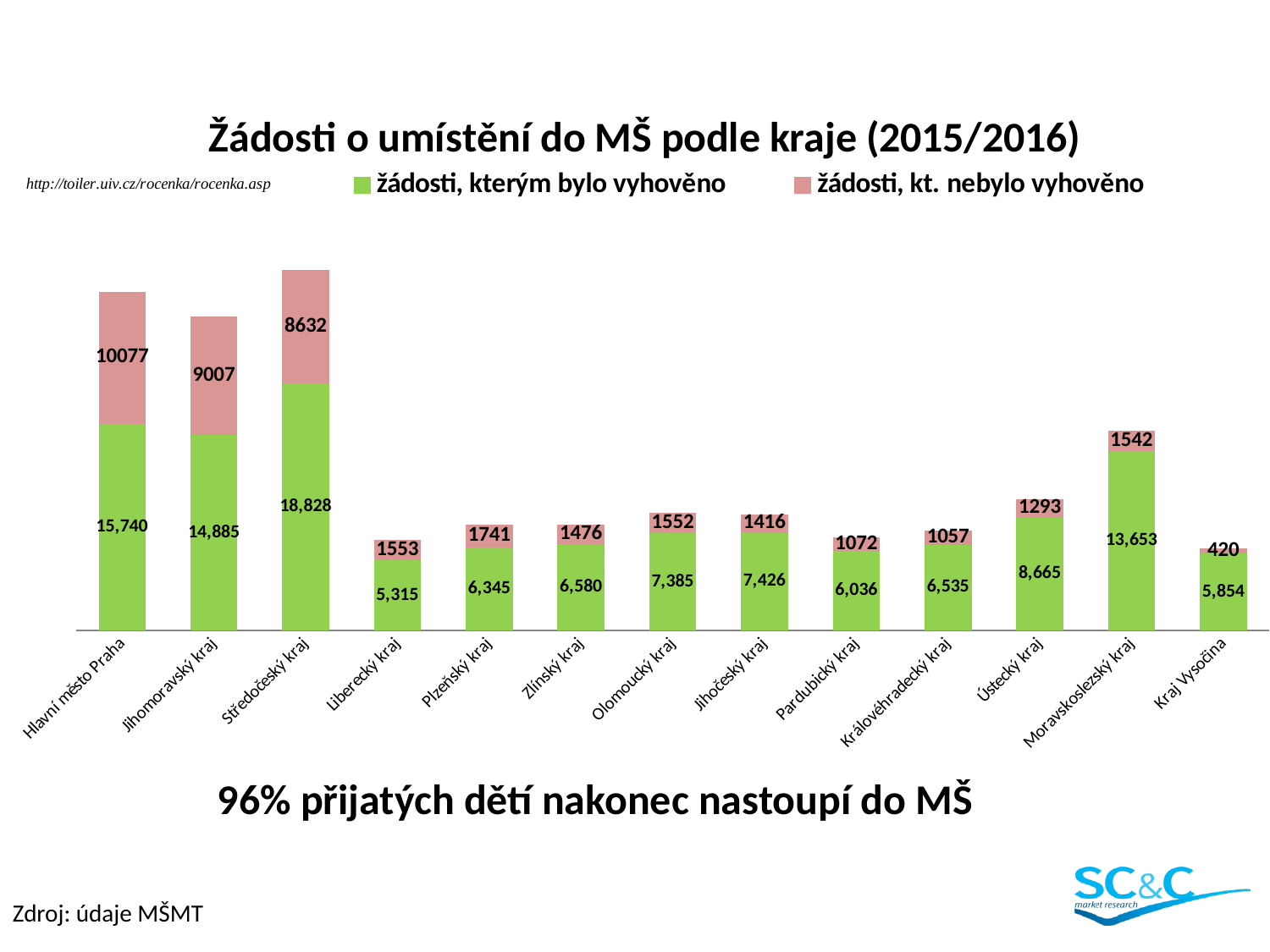
What is the title of the chart? Žádosti o umístění do MŠ podle kraje (2015/2016) How many series does the legend list? 2 What is the total of the stacked bar for Hlavní město Praha? 25,817 How many regions (kraje) are shown on the x axis? 13 What is the value of 'žádosti, kterým bylo vyhověno' for Kraj Vysočina? 5,854 What is the difference between 'žádosti, kterým bylo vyhověno' for Moravskoslezský kraj and Ústecký kraj? 4,988 Which region has the lowest value of 'žádosti, kt. nebylo vyhověno'? Kraj Vysočina What is the value of 'žádosti, kterým bylo vyhověno' for Středočeský kraj? 18,828 What is the value of 'žádosti, kt. nebylo vyhověno' for Hlavní město Praha? 10077 Which is larger: 'žádosti, kt. nebylo vyhověno' for Plzeňský kraj or for Zlínský kraj? Plzeňský kraj What type of chart is shown on the slide? stacked bar chart Which region has the highest value of 'žádosti, kterým bylo vyhověno'? Středočeský kraj